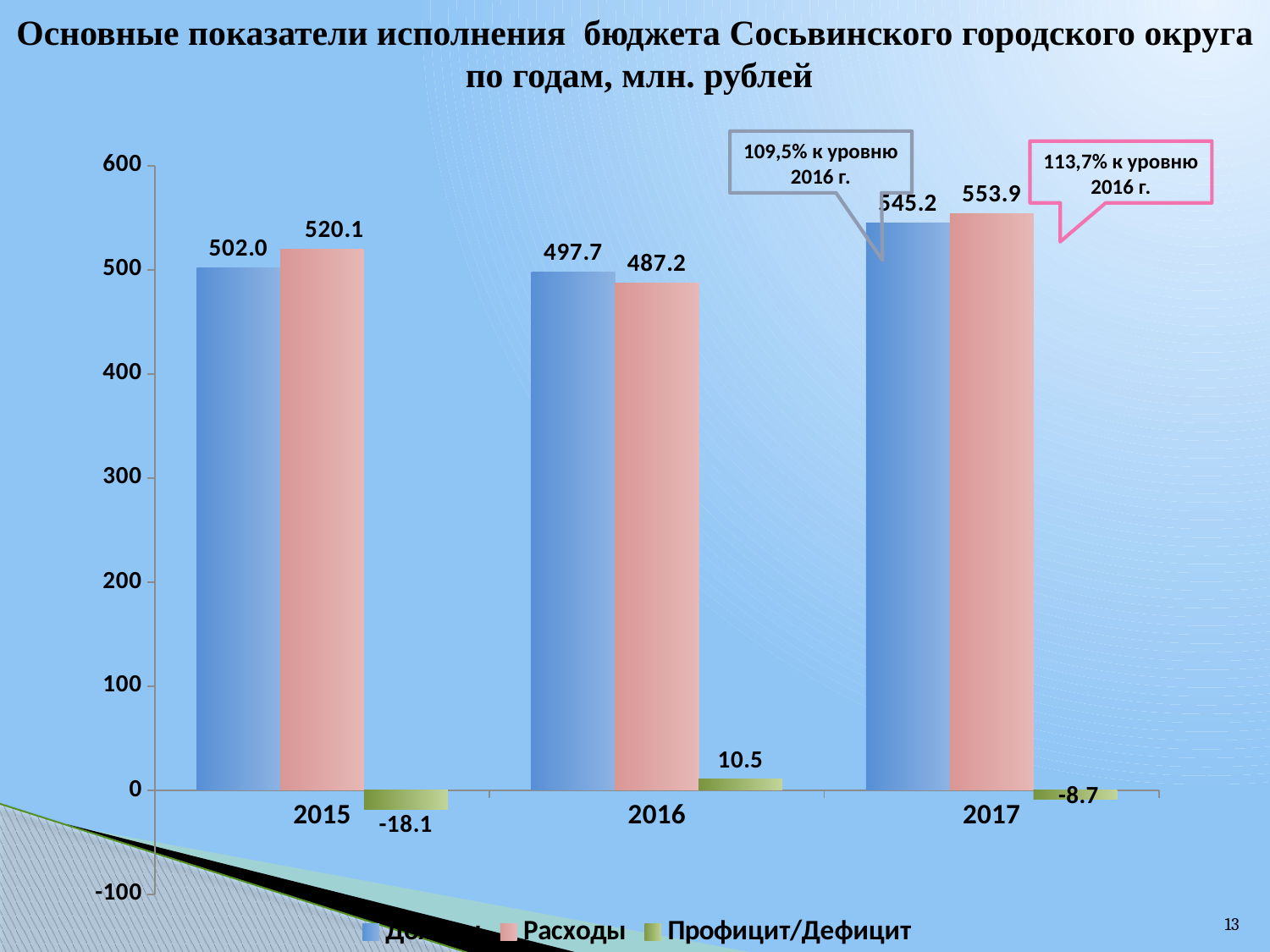
What is the value of the blue series for 2016? 497.7 Which is larger in 2016: the blue series or Расходы? the blue series What is the value of Профицит/Дефицит for 2016? 10.5 What is the value of Профицит/Дефицит for 2015? -18.1 In which year is Расходы the highest? 2017 What is the difference between Расходы in 2017 and Расходы in 2016? 66.7 What is the value of Расходы for 2015? 520.1 How many years are shown on the x axis? 3 In which year is Профицит/Дефицит the lowest? 2015 What type of chart is shown on the slide? bar chart How many series does the legend list? 3 What is the value of Расходы for 2017? 553.9